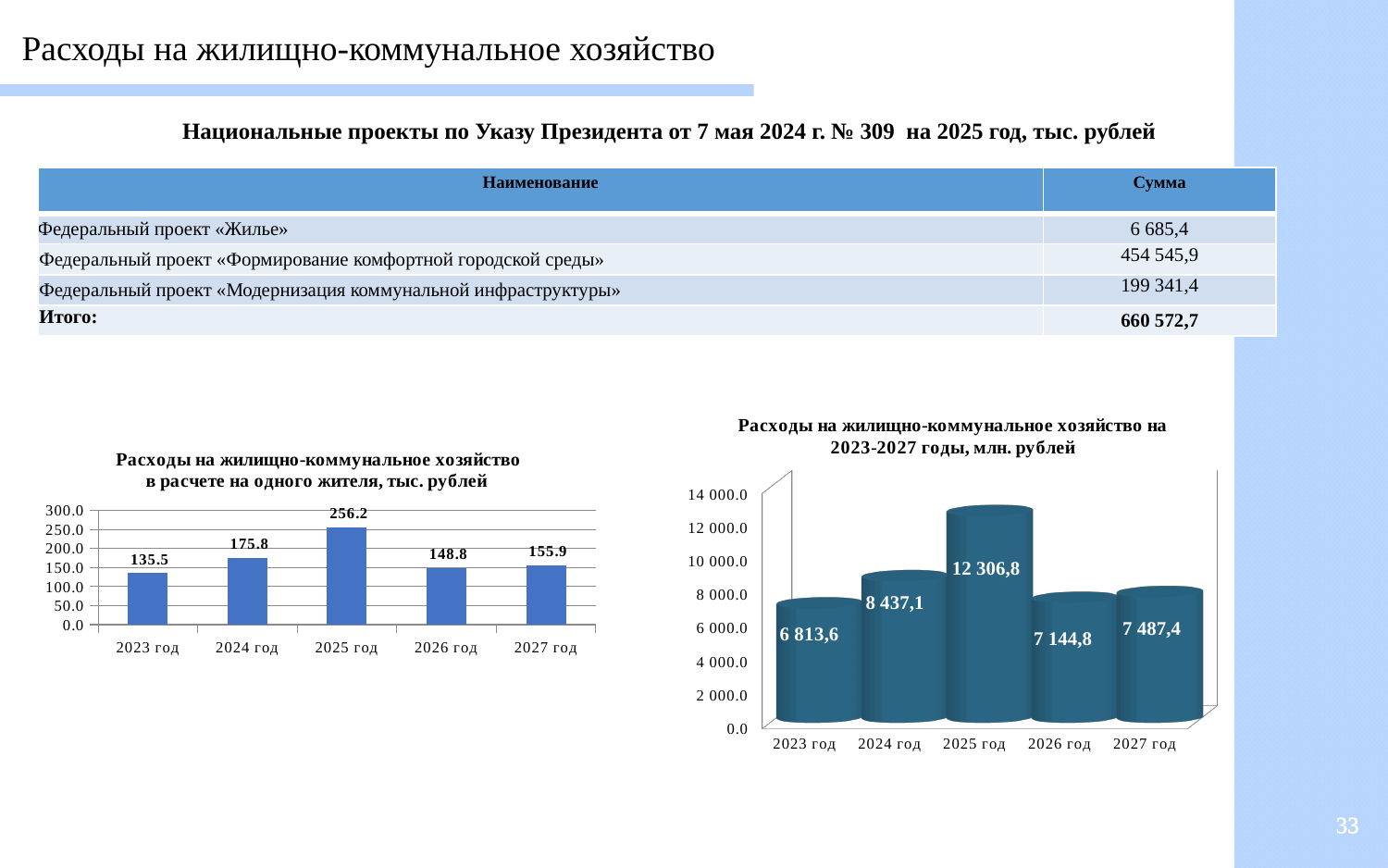
In the right chart (expenses for 2023-2027, million rubles), what is the value for 2024 год? 8 437,1 In the left chart (expenses per resident, thousand rubles), what is the difference between the values for 2024 год and 2023 год? 40.3 In the right chart (expenses for 2023-2027, million rubles), which year has the highest value? 2025 год What kind of chart is the right chart (expenses for 2023-2027, million rubles)? bar chart In the left chart (expenses per resident, thousand rubles), what is the value for 2025 год? 256.2 In the right chart (expenses for 2023-2027, million rubles), what is the value for 2027 год? 7 487,4 In the right chart (expenses for 2023-2027, million rubles), is the value for 2025 год greater or less than 12 000.0? greater In the left chart (expenses per resident, thousand rubles), which is larger: the value for 2026 год or 2027 год? 2027 год In the left chart (expenses per resident, thousand rubles), what is the value for 2023 год? 135.5 In the left chart (expenses per resident, thousand rubles), which year has the lowest value? 2023 год How many bars are shown in the left chart (expenses per resident, thousand rubles)? 5 In the right chart (expenses for 2023-2027, million rubles), do the values rise or fall from 2023 год to 2025 год? rise